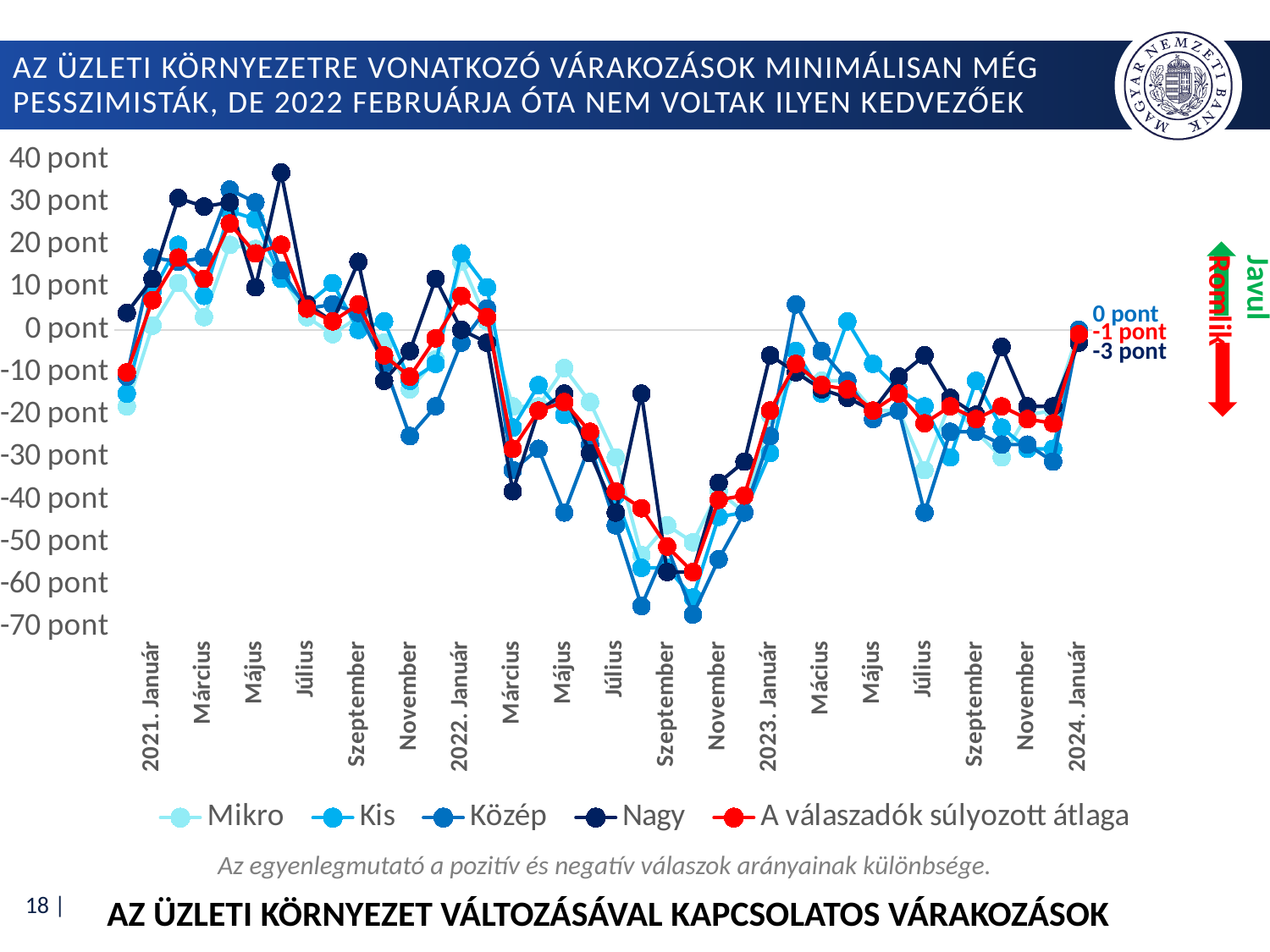
Is the lowest value of 'A válaszadók súlyozott átlaga' greater or less than -50 pont? less What kind of chart is shown on the slide? line chart At 2024. Január, which is larger: the value of 'A válaszadók súlyozott átlaga' or the value of Nagy? A válaszadók súlyozott átlaga Do the values of 'A válaszadók súlyozott átlaga' rise or fall between 2022. Szeptember and 2023. Január? rise What is the value of 'A válaszadók súlyozott átlaga' at 2024. Január? -1 pont What is the difference between 'A válaszadók súlyozott átlaga' (-1 pont) and Nagy (-3 pont) at 2024. Január? 2 pont What is the value of the Nagy series at 2024. Január? -3 pont Is the highest value of the Nagy series greater or less than 30 pont? greater What are the lowest and highest values shown on the vertical axis? -70 pont and 40 pont Which series is drawn in red? A válaszadók súlyozott átlaga Do the values of 'A válaszadók súlyozott átlaga' rise or fall between 2022. Január and 2022. Szeptember? fall How many series does the legend list? 5